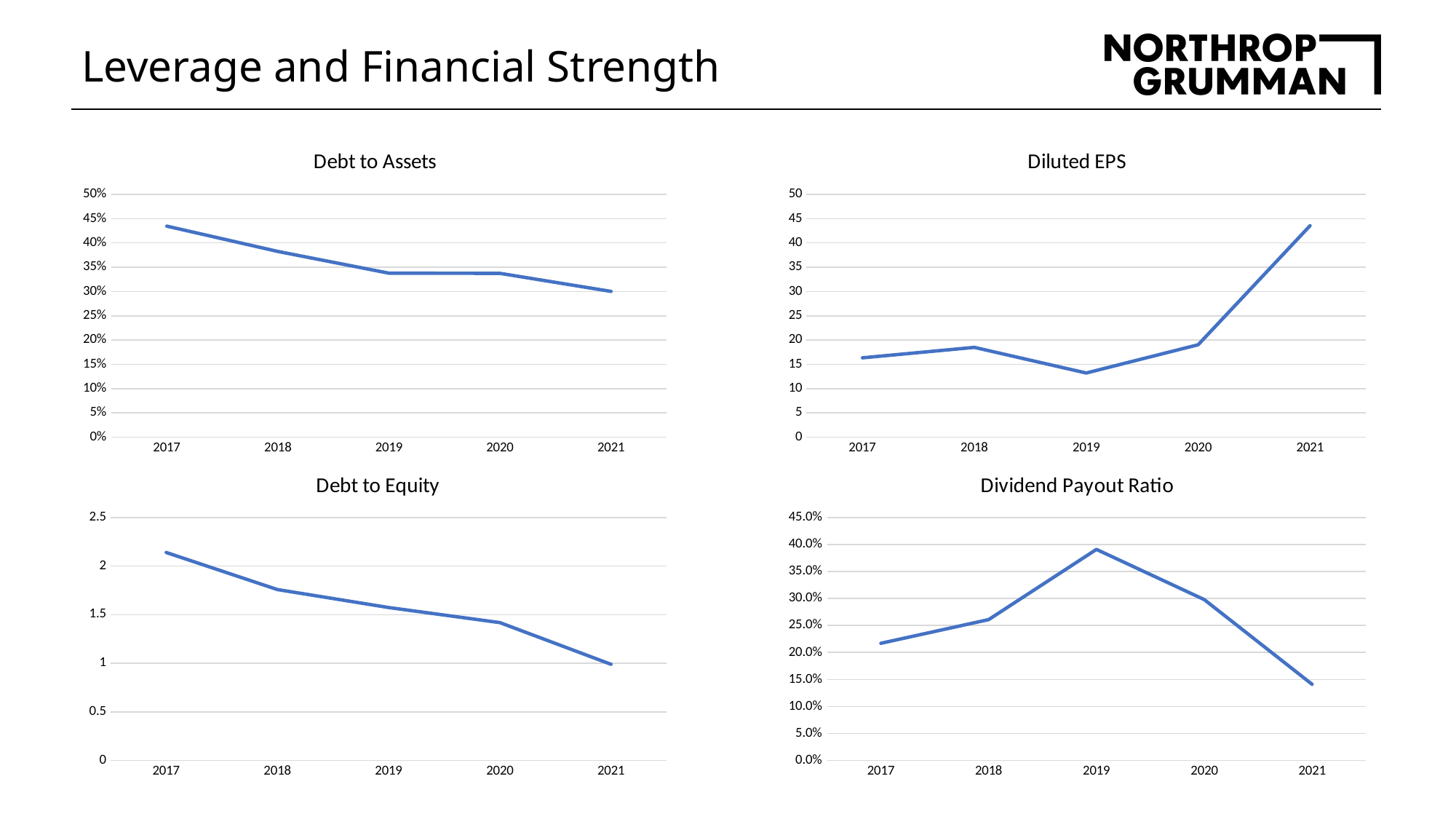
In the Diluted EPS chart, which year has the highest value? 2021 In the Dividend Payout Ratio chart, which year has the highest value? 2019 In the Dividend Payout Ratio chart, is the value for 2021 greater or less than 20.0%? less In the Diluted EPS chart, is the value for 2021 greater or less than 40? greater In the Debt to Equity chart, which year has the lowest value? 2021 In the Debt to Assets chart, is the value for 2017 greater or less than 40%? greater How many years are plotted on the x axis of the Debt to Equity chart? 5 In the Debt to Assets chart, which year has the highest value? 2017 In the Dividend Payout Ratio chart, which is larger, the value for 2018 or the value for 2020? 2020 In the Diluted EPS chart, which year has the lowest value? 2019 In the Debt to Assets chart, do the values rise or fall from 2017 to 2021? fall